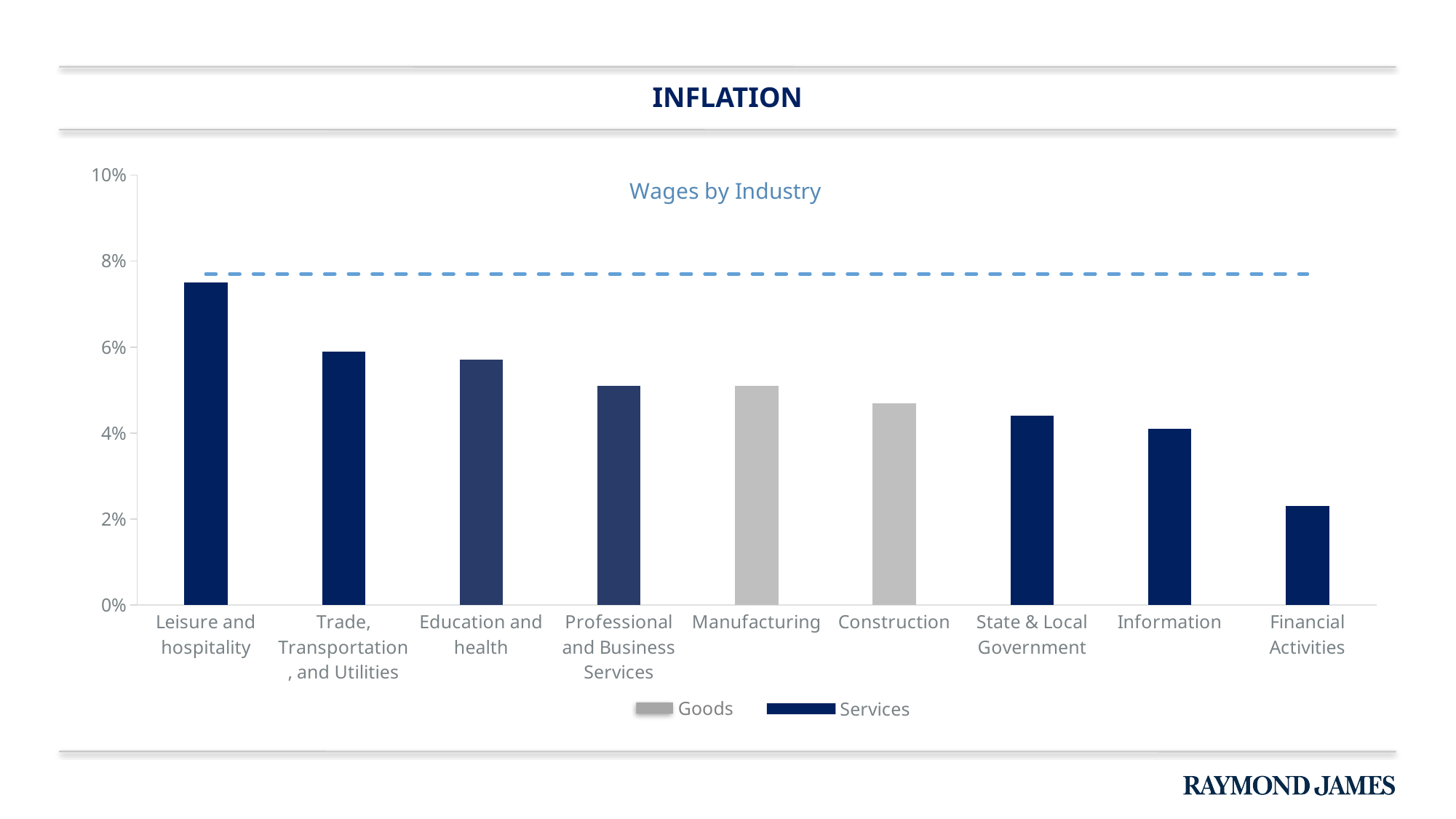
Is the value for Leisure and hospitality greater or less than 6%? greater What is the title of the chart? Wages by Industry Do the bar values generally rise or fall moving from left to right along the x axis? fall Which is larger, the value for Leisure and hospitality or the value for Trade, Transportation, and Utilities? Leisure and hospitality How many series does the legend list? 2 How many industries are shown on the x axis of the chart? 9 Which series is shown in grey according to the legend? Goods Which industry has the highest wage growth in the chart? Leisure and hospitality Is the value for Manufacturing greater or less than 4%? greater Which industry has the lowest wage growth in the chart? Financial Activities Is the value for Financial Activities greater or less than 4%? less What kind of chart is shown on the slide? bar chart